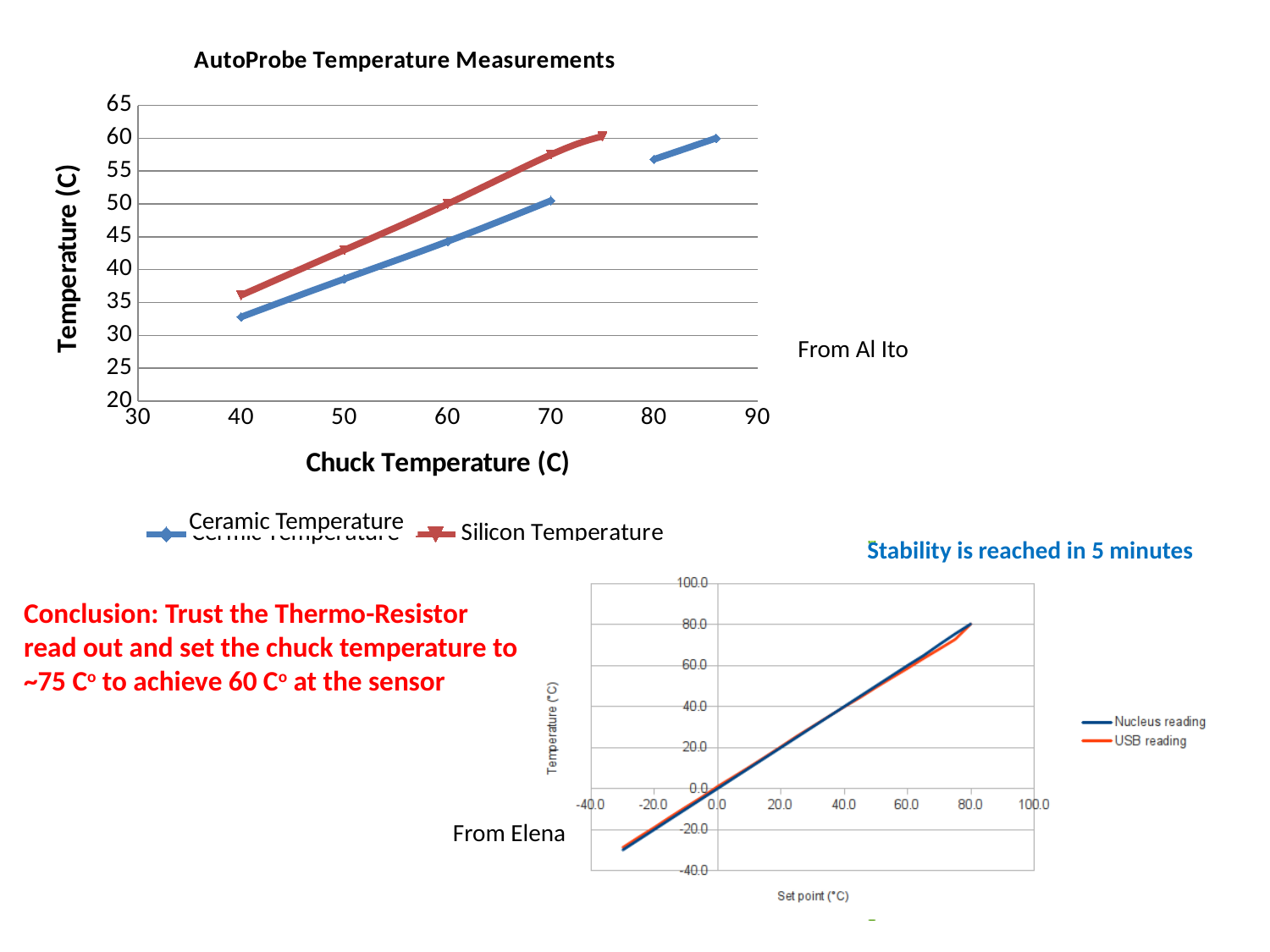
In the AutoProbe Temperature Measurements chart, do the Silicon Temperature values rise or fall as chuck temperature increases? rise In the AutoProbe Temperature Measurements chart, which series is plotted in red? Silicon Temperature In the AutoProbe Temperature Measurements chart, what is the title of the x axis? Chuck Temperature (C) In the AutoProbe Temperature Measurements chart, is the Silicon Temperature value at a chuck temperature of 60 greater or less than 45? greater In the AutoProbe Temperature Measurements chart, is the Ceramic Temperature value at a chuck temperature of 40 greater or less than 35? less In the AutoProbe Temperature Measurements chart, what kind of chart is shown? line chart In the AutoProbe Temperature Measurements chart, how many series does the legend list? 2 In the AutoProbe Temperature Measurements chart, is the Ceramic Temperature value at a chuck temperature of 60 greater or less than 50? less In the AutoProbe Temperature Measurements chart, at a chuck temperature of 60, which series has the higher value, Ceramic Temperature or Silicon Temperature? Silicon Temperature In the bottom chart (Set point vs Temperature), do the Nucleus reading values rise or fall as the set point increases? rise In the bottom chart (Set point vs Temperature), how many series does the legend list? 2